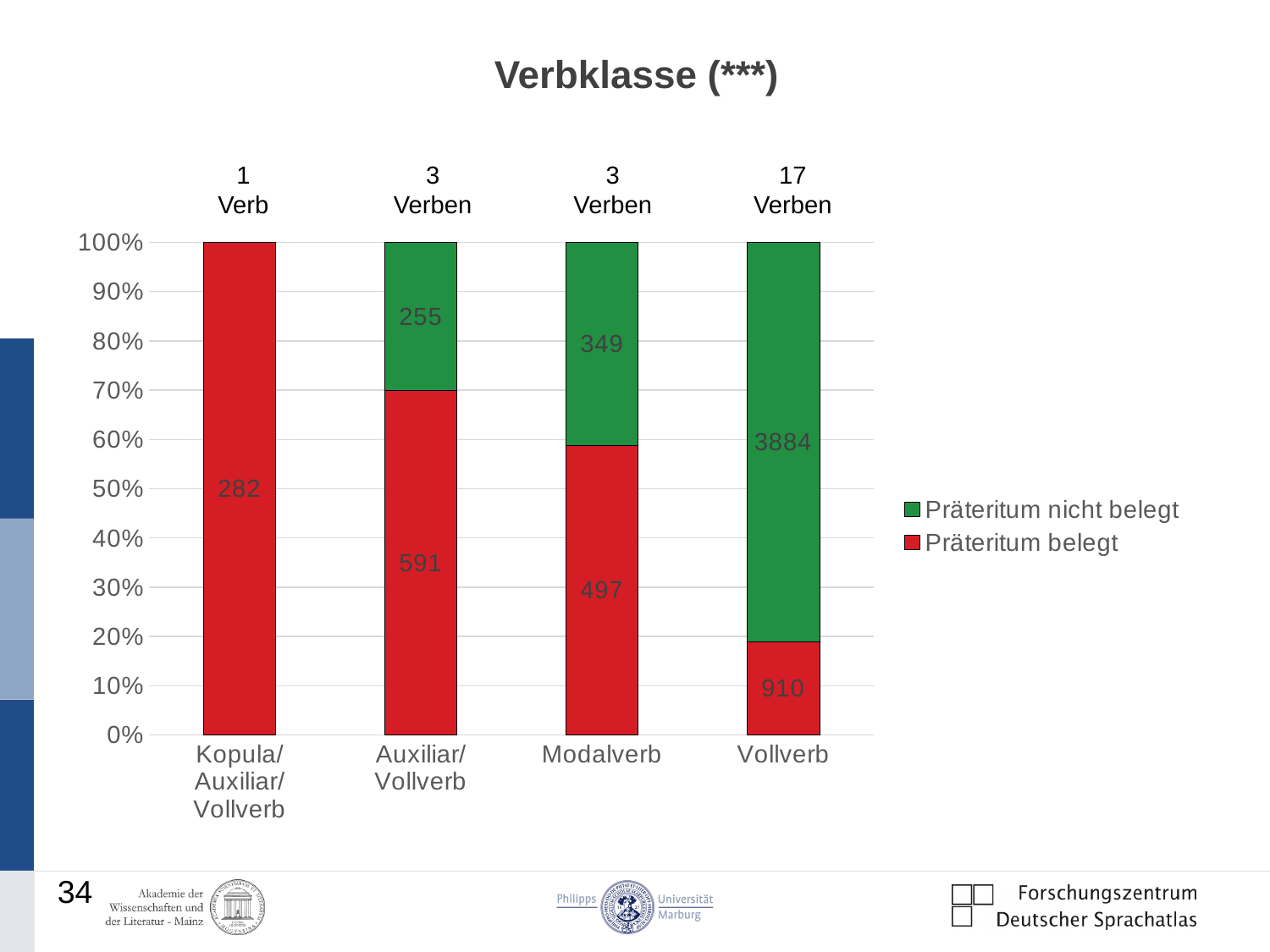
How many series does the legend list? 2 What is the title of the chart? Verbklasse (***) Which category has the lowest value for Präteritum belegt? Kopula/Auxiliar/Vollverb What is the value of Präteritum belegt for Modalverb? 497 What is the value of Präteritum nicht belegt for Vollverb? 3884 What type of chart is shown on the slide? stacked bar chart What is the difference between Präteritum belegt for Vollverb and for Auxiliar/Vollverb? 319 How many verb-class categories are shown on the x axis? 4 Which is larger: Präteritum nicht belegt for Modalverb or for Auxiliar/Vollverb? Modalverb What is the value of Präteritum belegt for Kopula/Auxiliar/Vollverb? 282 Which category has the highest value for Präteritum nicht belegt? Vollverb